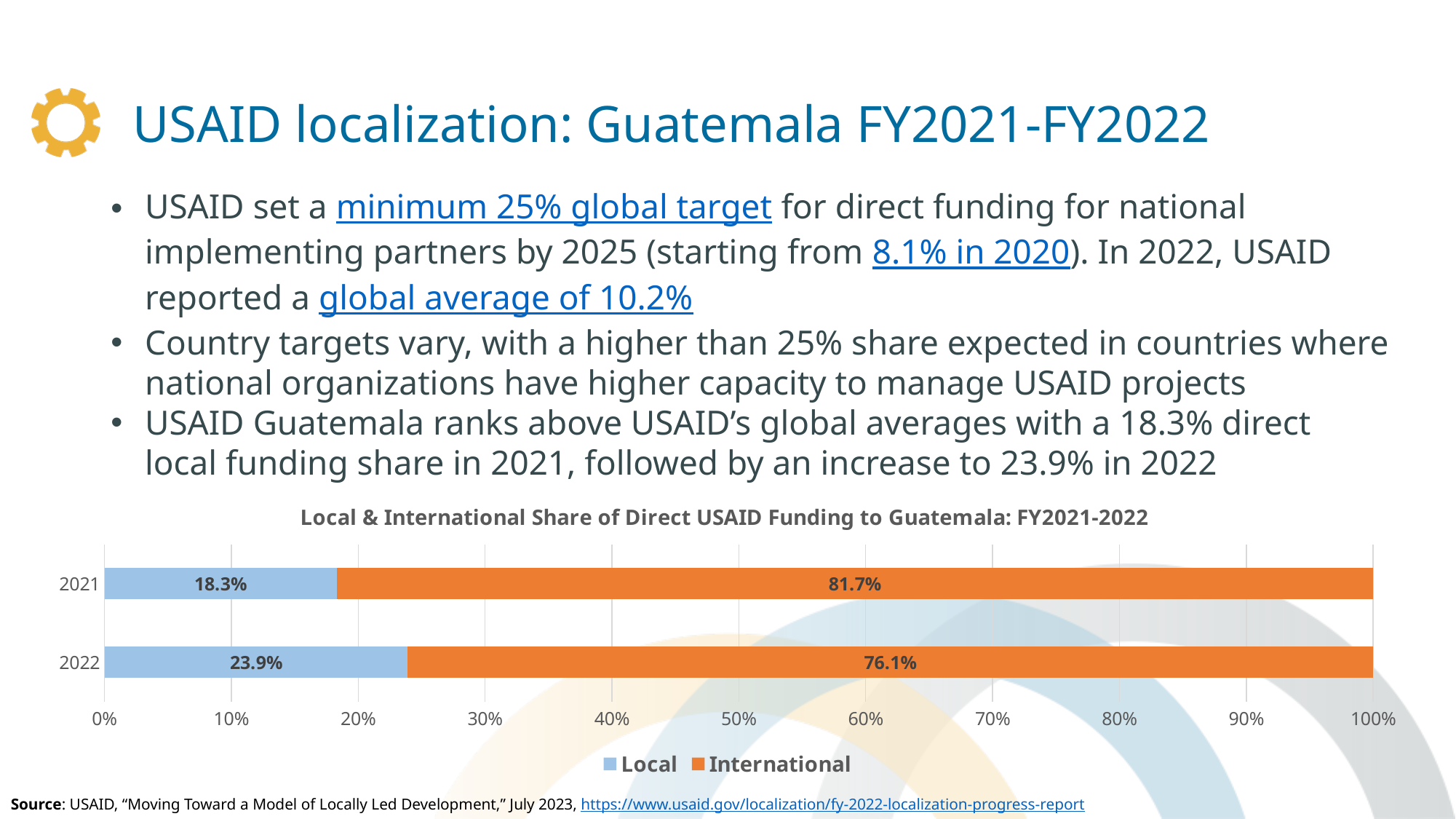
Is the Local share in 2022 larger or smaller than the International share in 2022? smaller Which year has the higher Local share of direct USAID funding to Guatemala? 2022 Which year has the lower International share of direct USAID funding to Guatemala? 2022 Is the Local share for 2021 greater or less than 20%? less How many series does the chart legend list? 2 What type of chart is shown on the slide? Stacked bar chart What is the International share of direct USAID funding to Guatemala in 2022? 76.1% By how many percentage points did the Local share increase from 2021 to 2022? 5.6 percentage points How many years are shown in the chart? 2 What is the Local share of direct USAID funding to Guatemala in 2021? 18.3% What is the Local share of direct USAID funding to Guatemala in 2022? 23.9% What is the International share of direct USAID funding to Guatemala in 2021? 81.7%